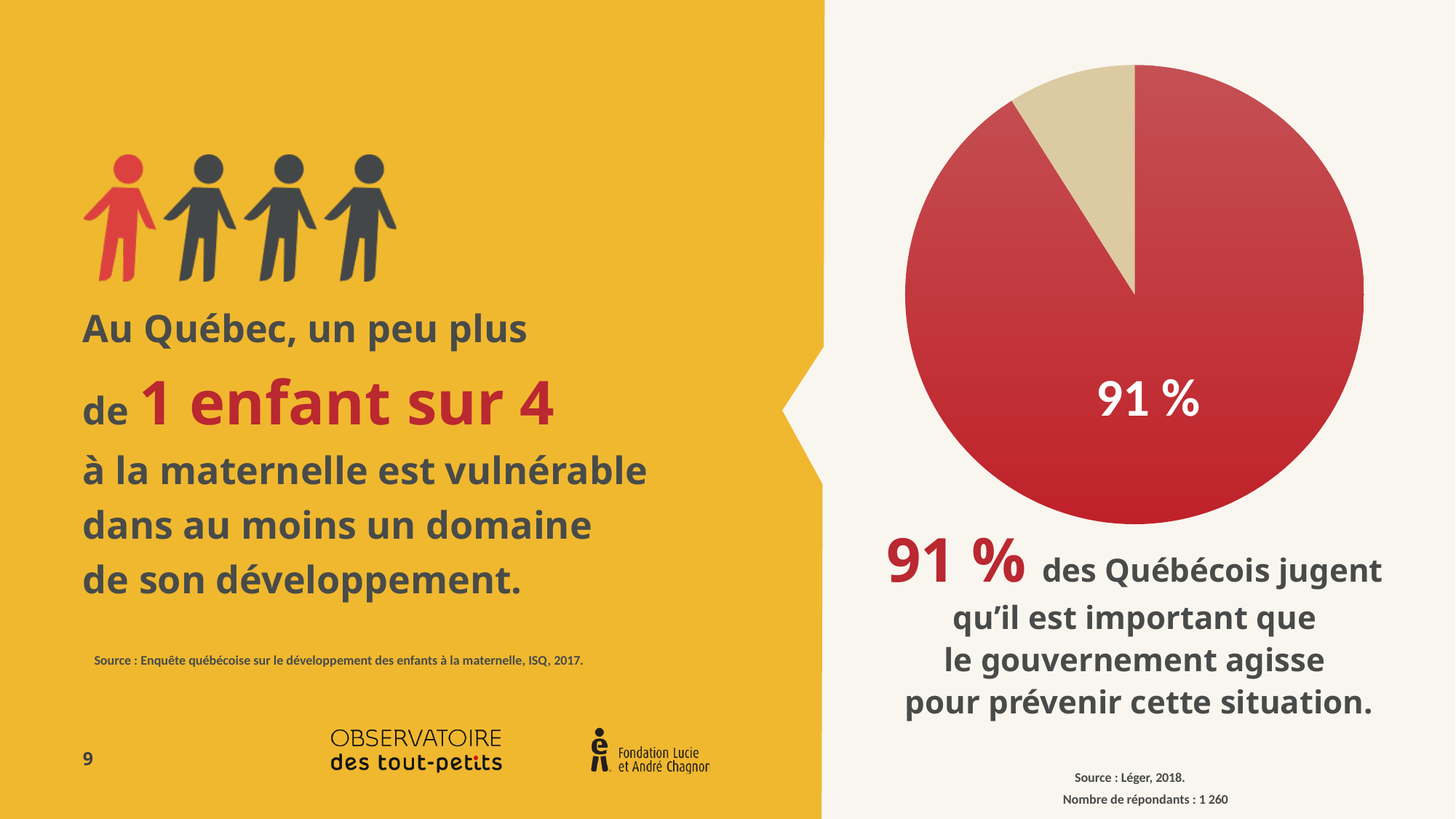
In the pictogram on the left side of the slide, how many of the figures are red? 1 What colour is the largest slice of the pie chart? red What kind of chart is shown on the right side of the slide? pie chart In the pie chart, what value is printed on the red slice? 91 % In the pictogram on the left side of the slide, how many person figures are shown? 4 What source is cited below the pie chart? Léger, 2018 In the pie chart, which slice is larger, the red one or the beige one? the red one What share of the pie chart does the red slice represent? 91 % How many slices does the pie chart have? 2 What percentage of Québécois judge it important that the government act, according to the pie chart? 91 %